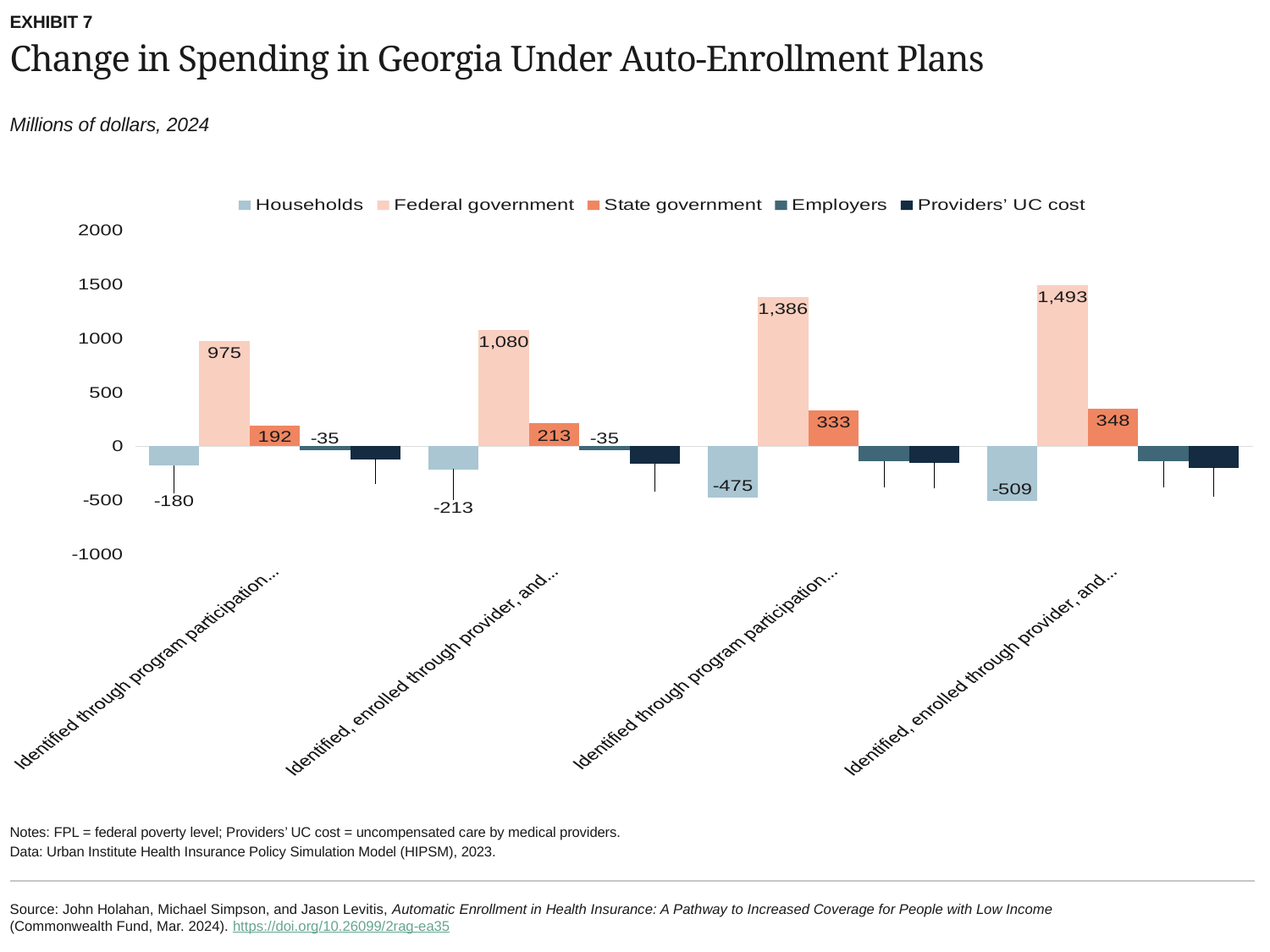
What is the difference between the Federal government value in the fourth group (1,493) and in the first group (975)? 518 What is the value for State government in the third group of bars? 333 How many series does the legend list? 5 Is the value for Employers in the third group greater or less than -500? greater What is the value for Employers in the second group of bars? -35 In which group of bars is the Federal government value the highest? The fourth (rightmost) group, 1,493 In which group of bars is the Households value the lowest? The fourth (rightmost) group, -509 What is the value for Households in the fourth (rightmost) group of bars? -509 How many groups of bars (categories) are shown on the x axis? 4 What is the value for Federal government in the first (leftmost) group of bars? 975 Which is larger: the State government value in the first group or in the second group? The second group (213) Do the Federal government values rise or fall from the leftmost group to the rightmost group? rise